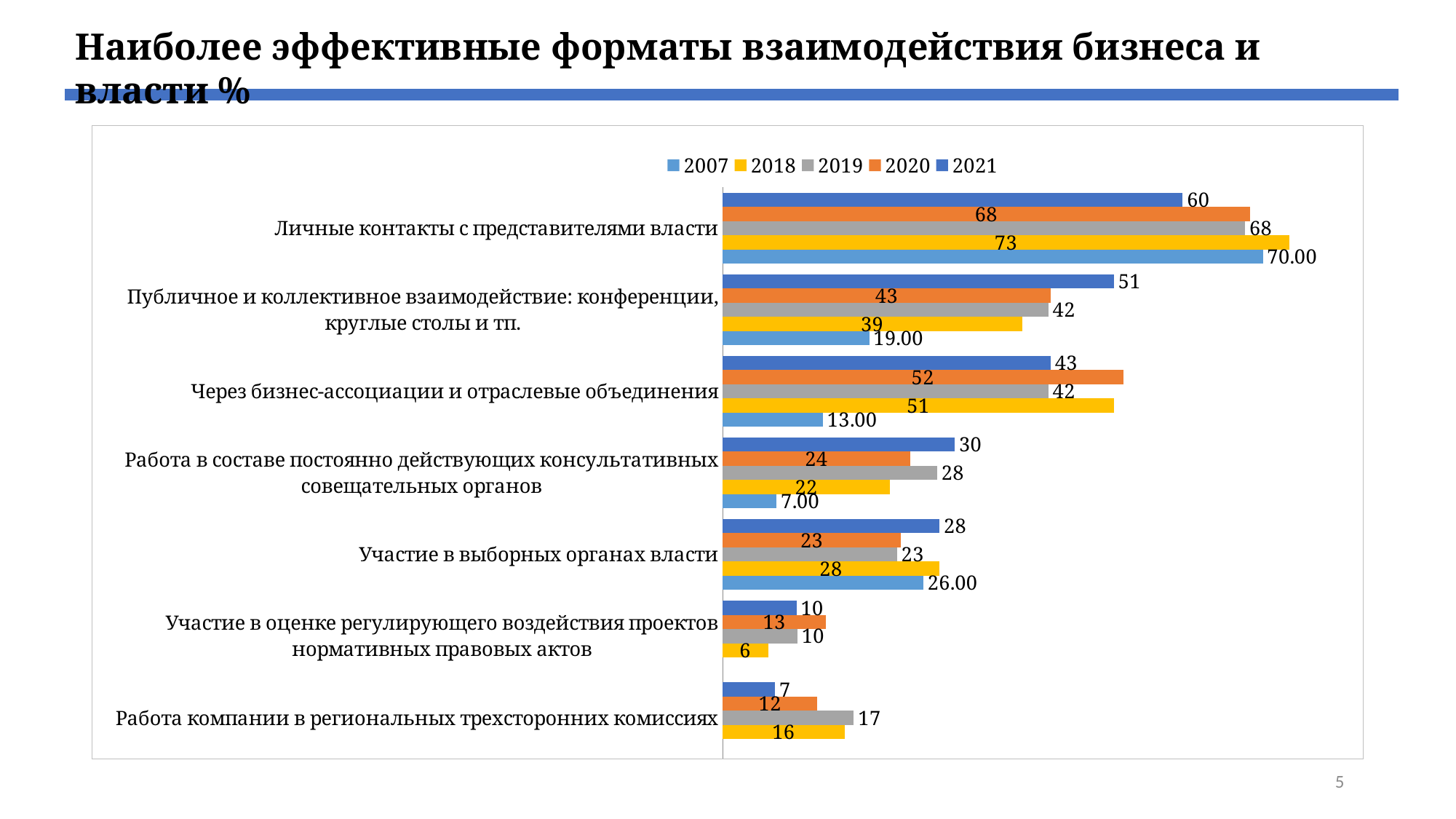
Which category has the lowest value for 2018? Участие в оценке регулирующего воздействия проектов нормативных правовых актов Which category has the highest value for 2021? Личные контакты с представителями власти In the category "Через бизнес-ассоциации и отраслевые объединения", which is larger: the value for 2020 or the value for 2021? 2020 What is the value for 2018 in the category "Личные контакты с представителями власти"? 73 How many series does the legend list? 5 Which series in the legend is shown in yellow? 2018 What is the value for 2007 in the category "Через бизнес-ассоциации и отраслевые объединения"? 13.00 What is the difference between the 2021 and 2007 values for "Публичное и коллективное взаимодействие: конференции, круглые столы и тп."? 32 What is the value for 2019 in the category "Работа в составе постоянно действующих консультативных совещательных органов"? 28 What kind of chart is shown on the slide? bar chart How many categories are shown on the chart? 7 What is the value for 2021 in the category "Работа компании в региональных трехсторонних комиссиях"? 7